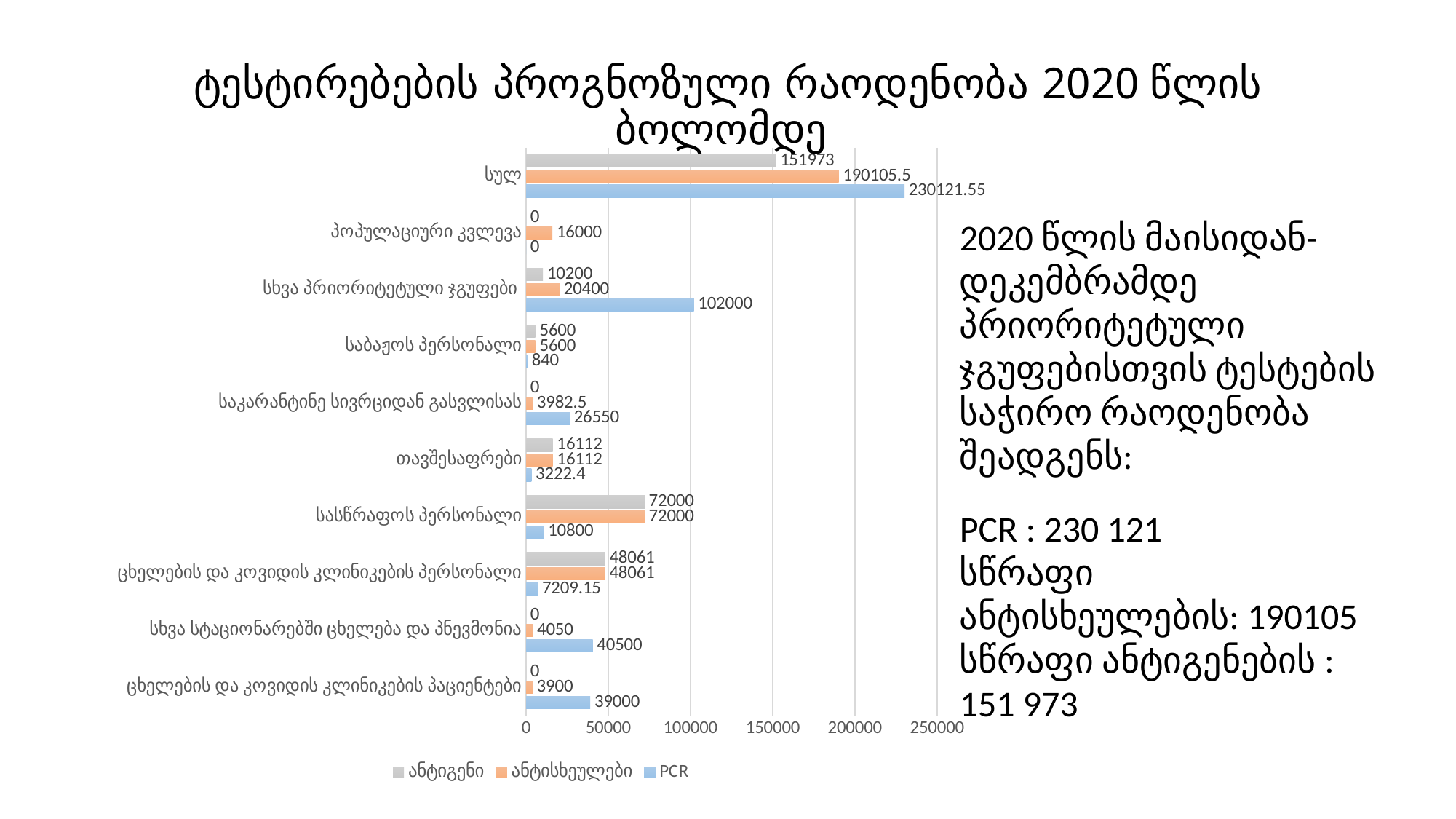
What is the PCR value for საკარანტინე სივრციდან გასვლისას? 26550 What is the PCR value for სულ? 230121.55 What is the difference between the PCR value and the ანტისხეულები value for სხვა სტაციონარებში ცხელება და პნევმონია? 36450 Which category has the lowest PCR value? პოპულაციური კვლევა For თავშესაფრები, which is larger: the ანტიგენი value or the PCR value? ანტიგენი How many categories are shown on the chart? 10 Is the ანტისხეულები value for სულ greater or less than 200000? less How many series does the legend list? 3 Excluding სულ, which category has the highest PCR value? სხვა პრიორიტეტული ჯგუფები What type of chart is shown on the slide? bar chart What is the ანტიგენი value for სასწრაფოს პერსონალი? 72000 What is the ანტისხეულები value for სხვა პრიორიტეტული ჯგუფები? 20400